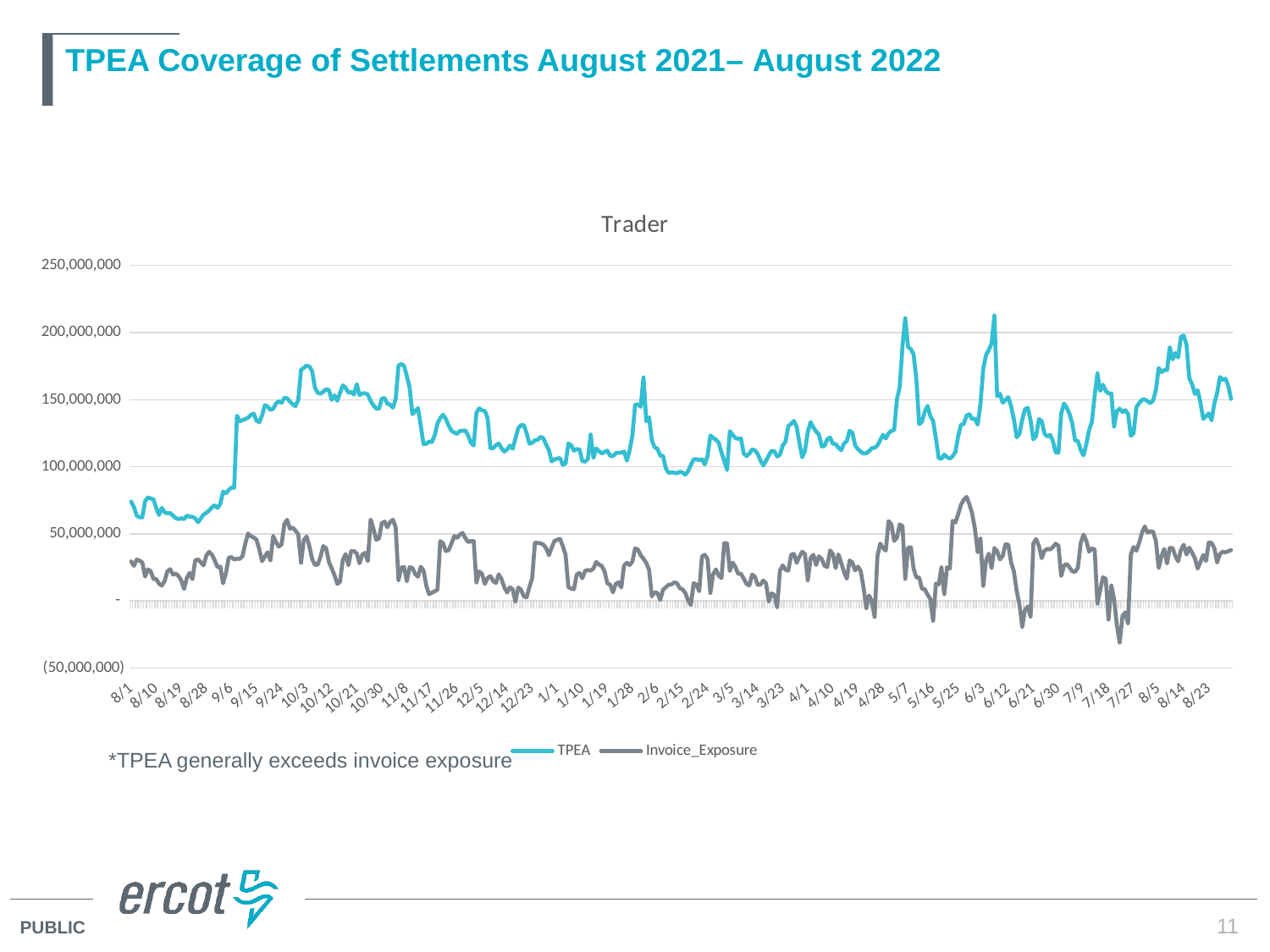
Is the TPEA value at 8/1 greater or less than 100,000,000? less Which series dips below zero around 7/27? Invoice_Exposure Is the TPEA value at 10/3 greater or less than 150,000,000? greater Which series reaches the highest value anywhere on the chart? TPEA What are the two series named in the chart's legend? TPEA and Invoice_Exposure What kind of chart is shown on the slide? line chart Is the peak TPEA value near 5/7 greater or less than 200,000,000? greater Does the TPEA line rise or fall between 8/28 and 10/3? rise How many series does the chart's legend list? 2 What is the title printed above the chart's plot area? Trader Which series is higher at 10/3, TPEA or Invoice_Exposure? TPEA